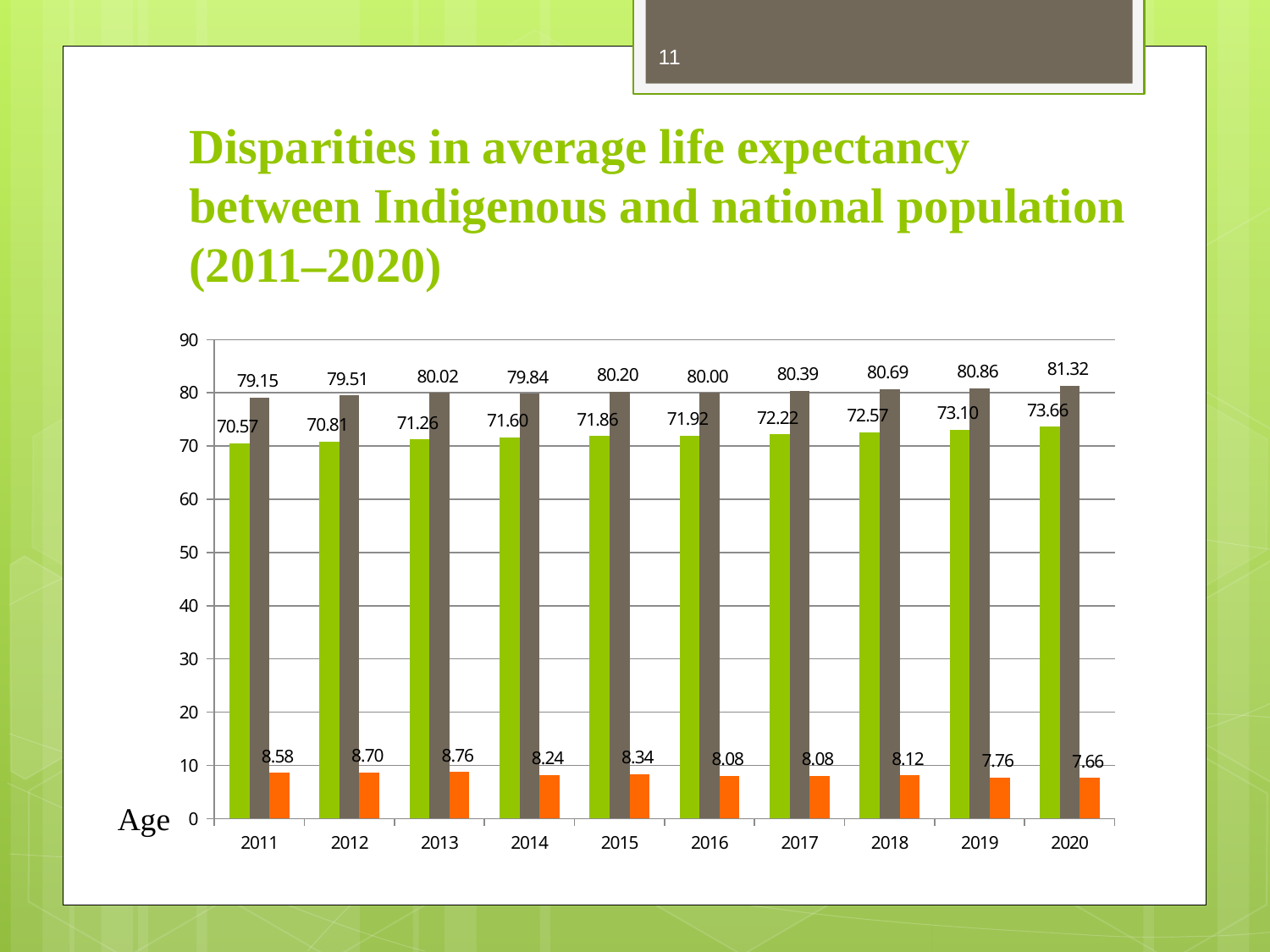
What is the value of the green bar for 2011? 70.57 What is the value of the orange bar for 2014? 8.24 Which is larger, the grey bar for 2013 or the grey bar for 2014? 2013 What is the difference between the grey bar and the green bar in 2020? 7.66 What kind of chart is shown on the slide? bar chart Is the value of the green bar for 2015 greater or less than 70? greater In which year is the orange bar highest? 2013 Do the green bars rise or fall from 2011 to 2020? rise In which year is the green bar lowest? 2011 In which year is the orange bar lowest? 2020 What is the value of the grey bar for 2020? 81.32 How many years are shown on the x axis? 10